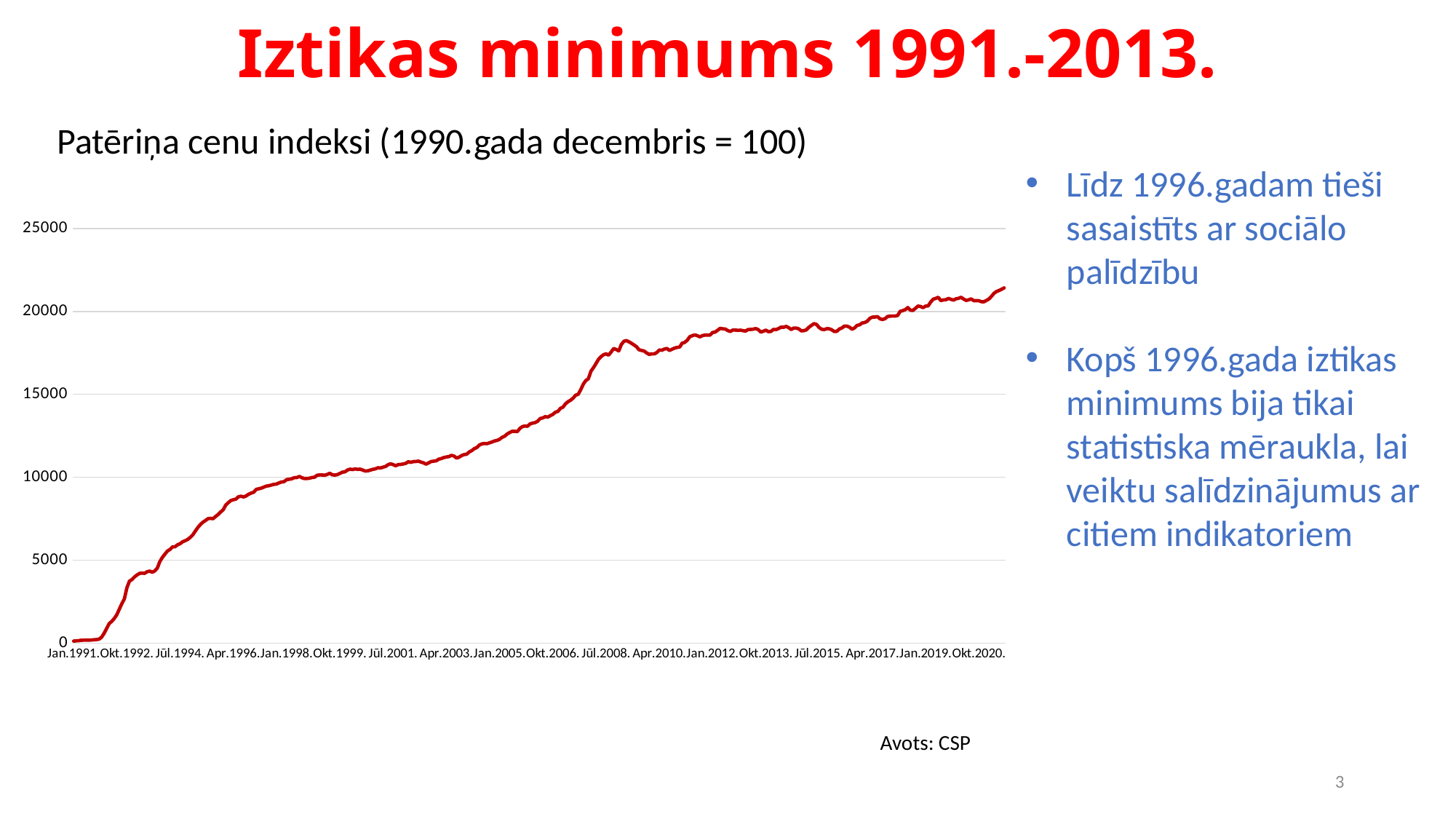
Is the value for Jan.1991 greater or less than 5000? less Which is larger, the value for Jan.1998 or the value for Jan.2012? Jan.2012 Is the value for Okt.2020 greater or less than 20000? greater What is the title of the chart? Patēriņa cenu indeksi (1990.gada decembris = 100) At which x-axis label is the plotted value highest? Okt.2020 How many lines (series) are plotted in the chart? 1 What kind of chart is shown on the slide? line chart Do the values generally rise or fall along the x axis from Jan.1991 to Okt.2020? rise Is the value for Apr.1996 greater or less than 10000? less What colour is the line plotted in the chart? red At which x-axis label is the plotted value lowest? Jan.1991